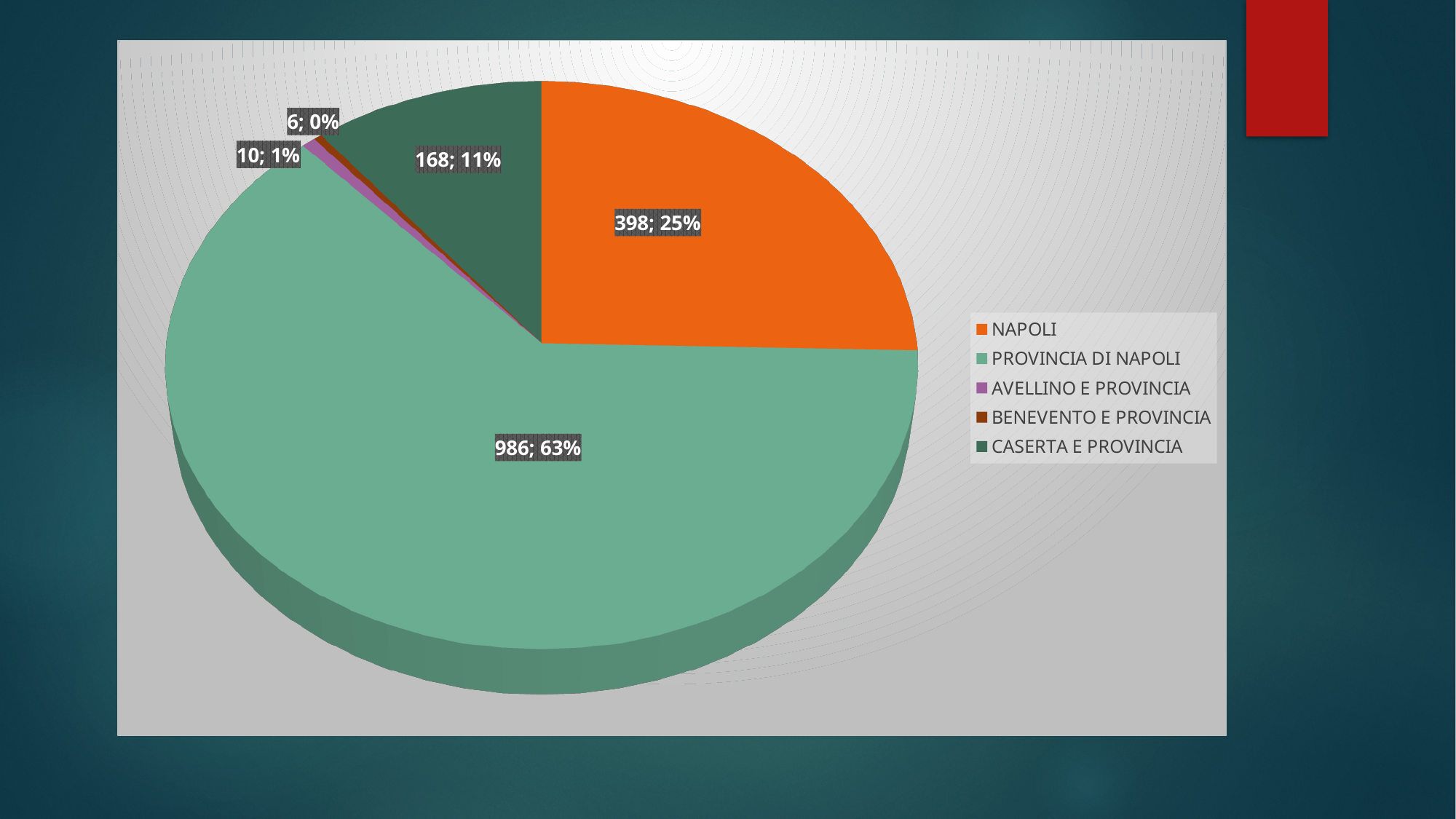
Which is larger, the value for NAPOLI or the value for CASERTA E PROVINCIA? NAPOLI What value is shown for CASERTA E PROVINCIA? 168 Which category has the smallest slice of the pie chart? BENEVENTO E PROVINCIA What value is shown for BENEVENTO E PROVINCIA? 6 What percentage is shown for AVELLINO E PROVINCIA? 1% What colour is the slice for NAPOLI in the pie chart? Orange Which category has the largest slice of the pie chart? PROVINCIA DI NAPOLI What percentage share does PROVINCIA DI NAPOLI have in the pie chart? 63% What is the difference between the values for PROVINCIA DI NAPOLI and NAPOLI? 588 What value is shown for the NAPOLI slice of the pie chart? 398 How many categories does the pie chart show? 5 What type of chart is shown on the slide? Pie chart